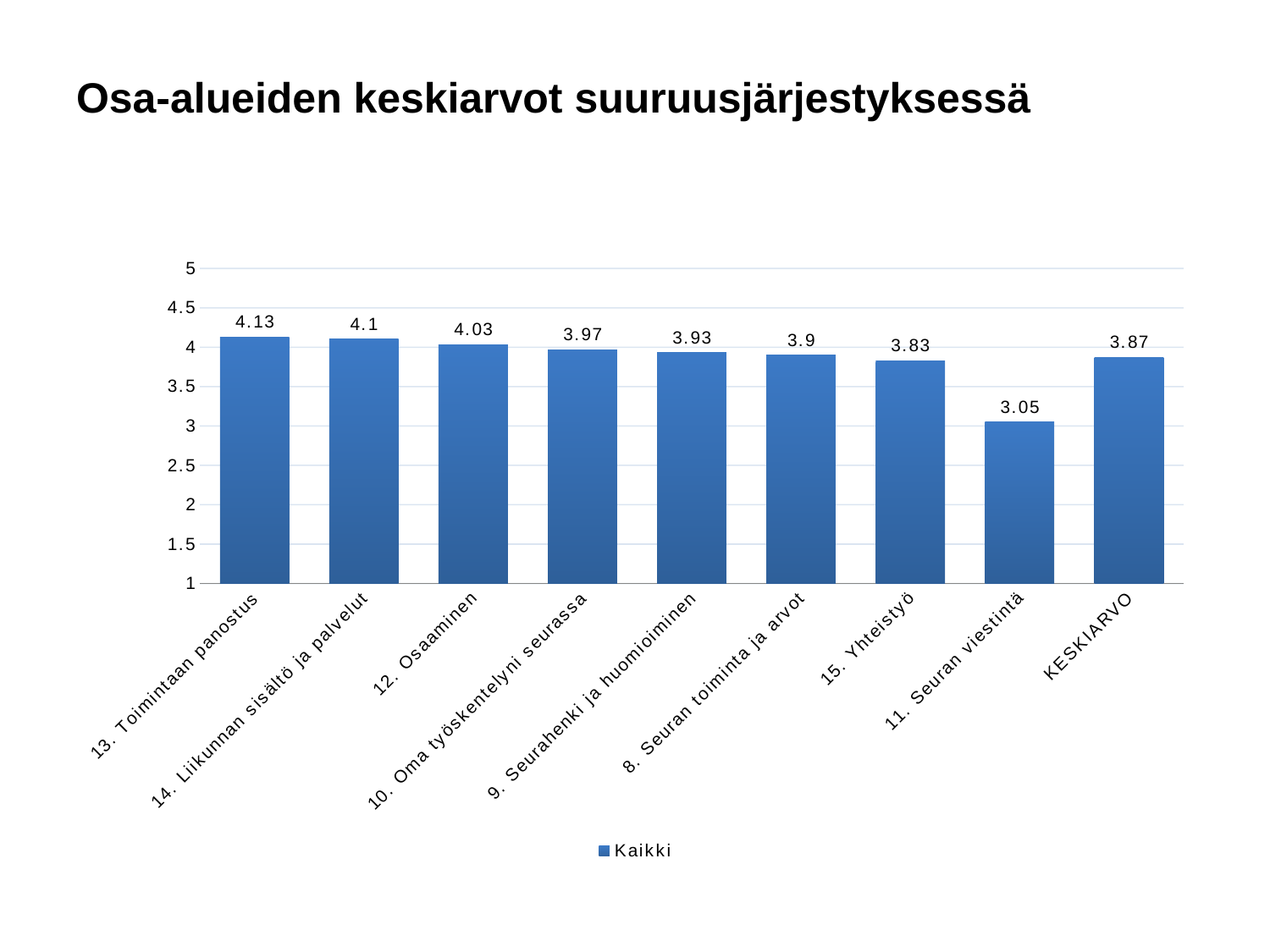
Which is larger, the value for 12. Osaaminen or the value for 15. Yhteistyö? 12. Osaaminen Is the value for 11. Seuran viestintä greater or less than 3.5? less What is the value for 11. Seuran viestintä? 3.05 What is the value for 9. Seurahenki ja huomioiminen? 3.93 What is the legend entry for the series? Kaikki What kind of chart is shown on the slide? bar chart How many categories are shown on the x axis? 9 What is the value for 13. Toimintaan panostus? 4.13 Which category has the highest value? 13. Toimintaan panostus Which category has the lowest value? 11. Seuran viestintä What is the value for KESKIARVO? 3.87 What is the difference between the values for 13. Toimintaan panostus and 11. Seuran viestintä? 1.08